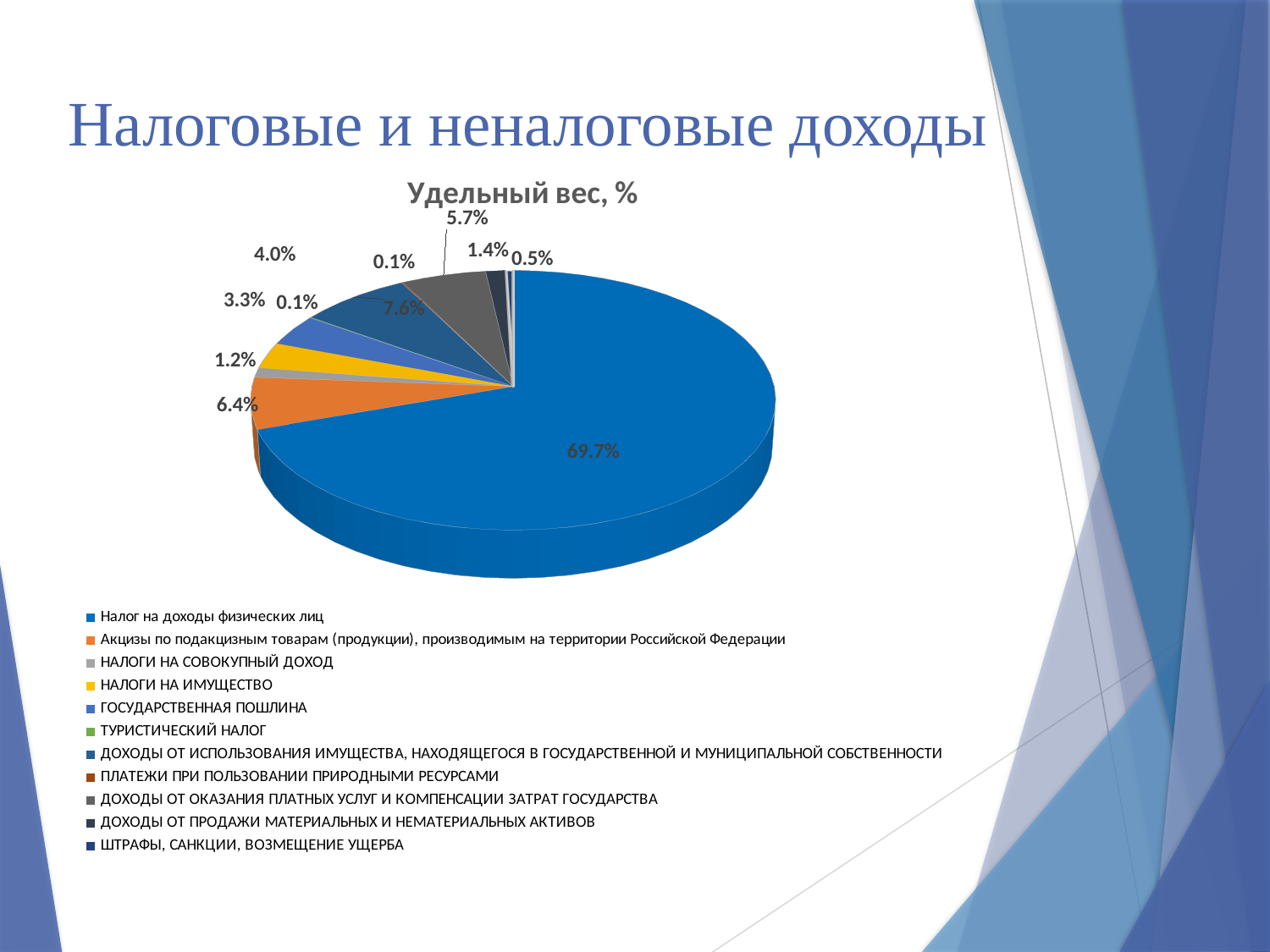
What kind of chart is shown on the slide? pie chart By how many percentage points does the share of "Налог на доходы физических лиц" exceed the share of "Акцизы по подакцизным товарам"? 63.3 What is the title of the chart? Удельный вес, % Which category has the largest slice of the pie? Налог на доходы физических лиц What is the share for "ДОХОДЫ ОТ ИСПОЛЬЗОВАНИЯ ИМУЩЕСТВА, НАХОДЯЩЕГОСЯ В ГОСУДАРСТВЕННОЙ И МУНИЦИПАЛЬНОЙ СОБСТВЕННОСТИ"? 7.6% What share of the pie does "Налог на доходы физических лиц" have? 69.7% What is the smallest share value labelled on the pie? 0.1% What is the share for "ДОХОДЫ ОТ ОКАЗАНИЯ ПЛАТНЫХ УСЛУГ И КОМПЕНСАЦИИ ЗАТРАТ ГОСУДАРСТВА"? 5.7% What is the share for "Акцизы по подакцизным товарам (продукции), производимым на территории Российской Федерации"? 6.4% Which is larger: the share for "Акцизы по подакцизным товарам" or the share for "ДОХОДЫ ОТ ИСПОЛЬЗОВАНИЯ ИМУЩЕСТВА, НАХОДЯЩЕГОСЯ В ГОСУДАРСТВЕННОЙ И МУНИЦИПАЛЬНОЙ СОБСТВЕННОСТИ"? ДОХОДЫ ОТ ИСПОЛЬЗОВАНИЯ ИМУЩЕСТВА, НАХОДЯЩЕГОСЯ В ГОСУДАРСТВЕННОЙ И МУНИЦИПАЛЬНОЙ СОБСТВЕННОСТИ How many categories does the chart's legend list? 11 What is the share for "НАЛОГИ НА ИМУЩЕСТВО"? 3.3%